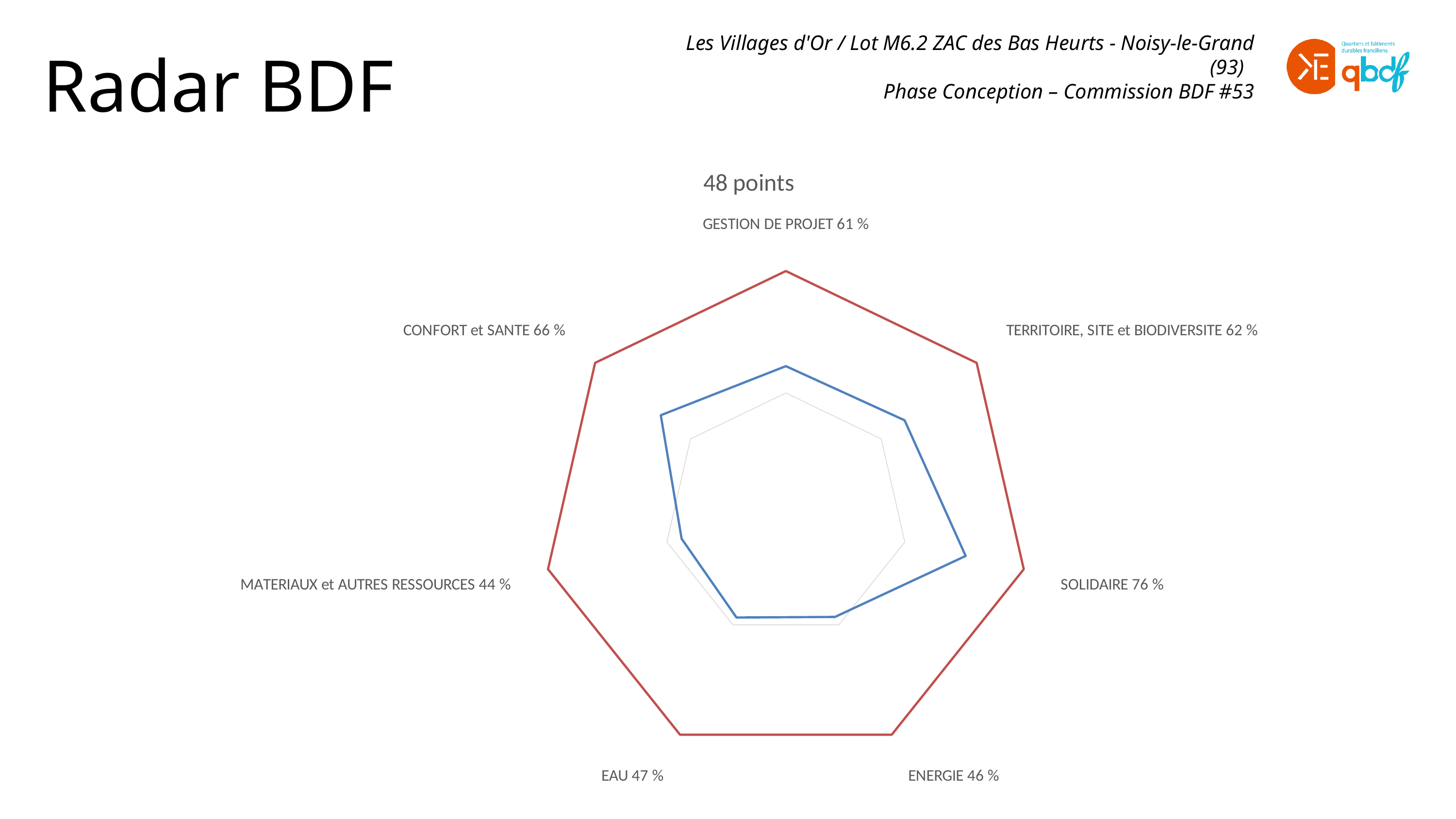
How many categories (axes) does the radar chart have? 7 What is the difference between the SOLIDAIRE percentage and the MATERIAUX et AUTRES RESSOURCES percentage? 32 % What is the difference between the EAU percentage and the ENERGIE percentage? 1 % What is the chart's title? 48 points What percentage is shown for ENERGIE? 46 % Which category has the lowest percentage? MATERIAUX et AUTRES RESSOURCES What percentage is shown for MATERIAUX et AUTRES RESSOURCES? 44 % What kind of chart is shown on the slide? Radar chart What percentage is shown for GESTION DE PROJET? 61 % What percentage is shown for SOLIDAIRE? 76 % Which has a higher percentage, CONFORT et SANTE or TERRITOIRE, SITE et BIODIVERSITE? CONFORT et SANTE Which category has the highest percentage? SOLIDAIRE